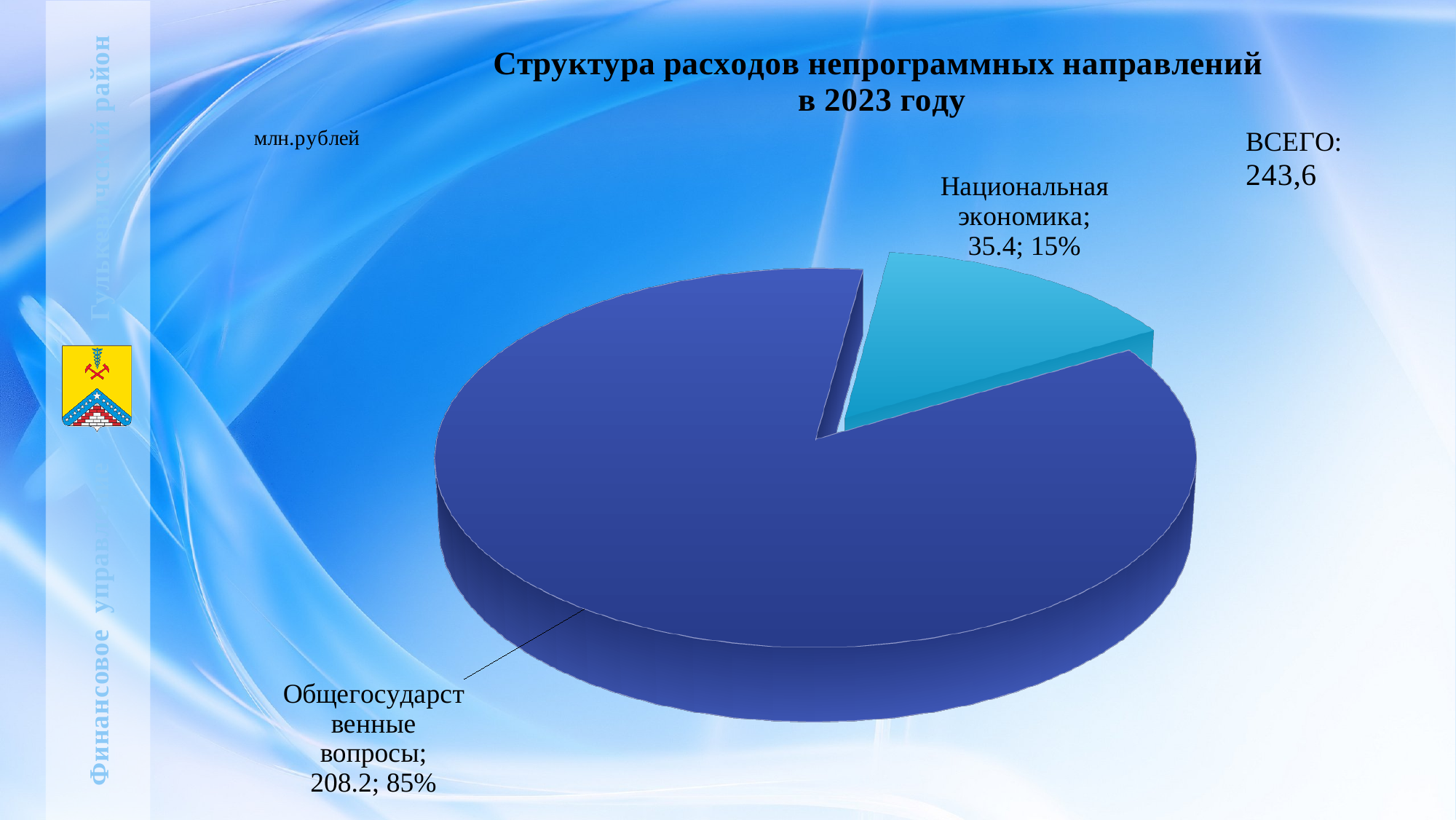
What total (ВСЕГО) is shown on the slide? 243,6 Which is larger, Общегосударственные вопросы or Национальная экономика? Общегосударственные вопросы What is the value for Национальная экономика? 35.4 How many slices does the pie chart have? 2 What is the difference between the values for Общегосударственные вопросы and Национальная экономика? 172.8 What kind of chart is shown on the slide? pie chart Which category has the smallest slice? Национальная экономика What share of the pie does Общегосударственные вопросы take? 85% Which category has the largest slice? Общегосударственные вопросы What share of the pie does Национальная экономика take? 15% What unit of measurement is indicated for the chart? млн.рублей What is the value for Общегосударственные вопросы? 208.2